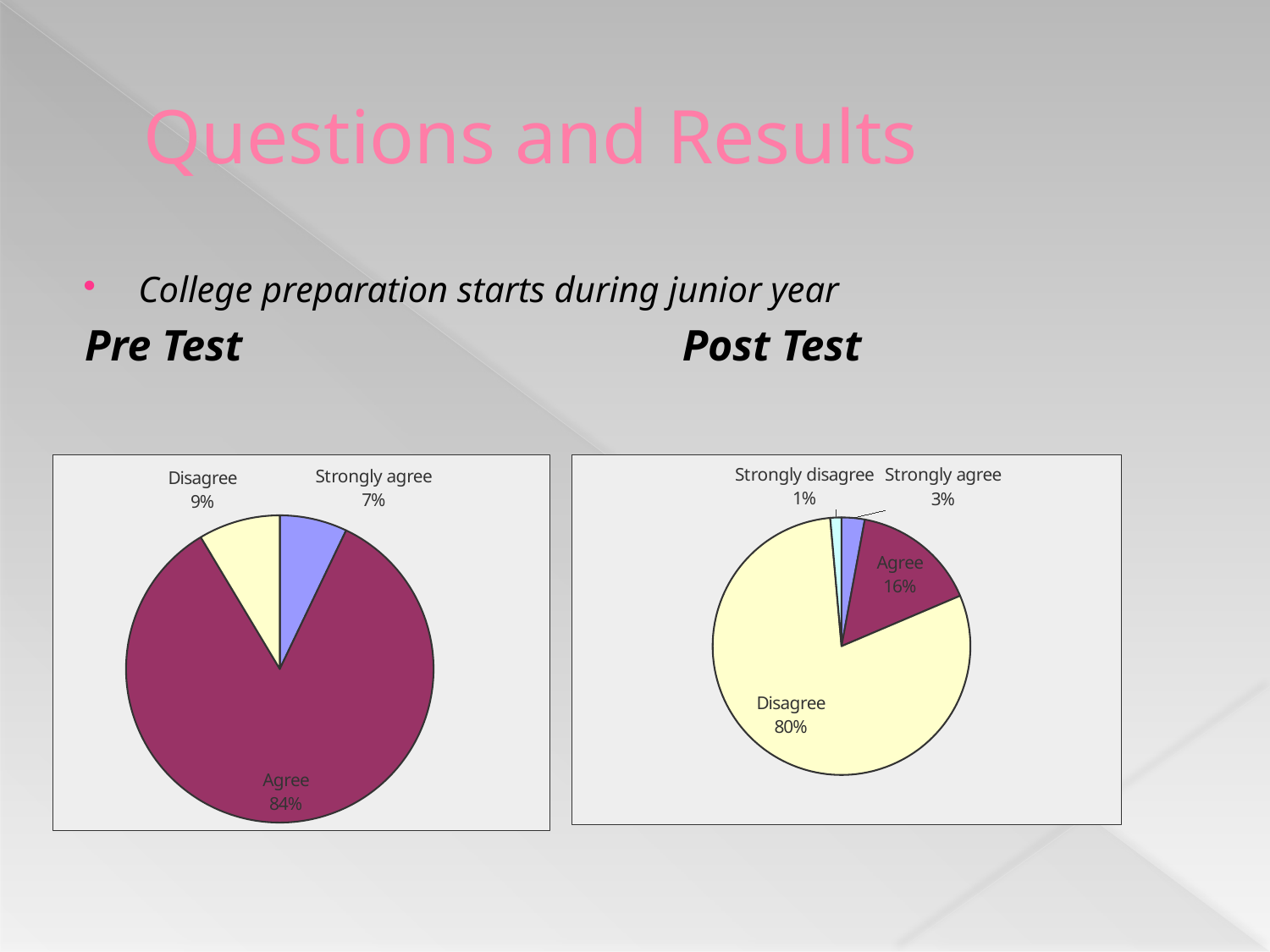
In the Pre Test pie chart, what share of responses is Strongly agree? 7% In the Pre Test pie chart, what share of responses is Disagree? 9% In the Post Test pie chart, what share of responses is Agree? 16% In the Post Test pie chart, which category has the largest slice? Disagree In the Post Test pie chart, what is the difference between the Disagree and Agree shares? 64% In the Post Test pie chart, what share of responses is Strongly disagree? 1% In the Pre Test pie chart, which category has the smallest slice? Strongly agree What type of chart is the Pre Test chart? Pie chart In the Pre Test pie chart, what share of responses is Agree? 84% In the Post Test pie chart, which category has the smallest slice? Strongly disagree In the Post Test pie chart, what share of responses is Disagree? 80% How many slices does the Post Test pie chart have? 4